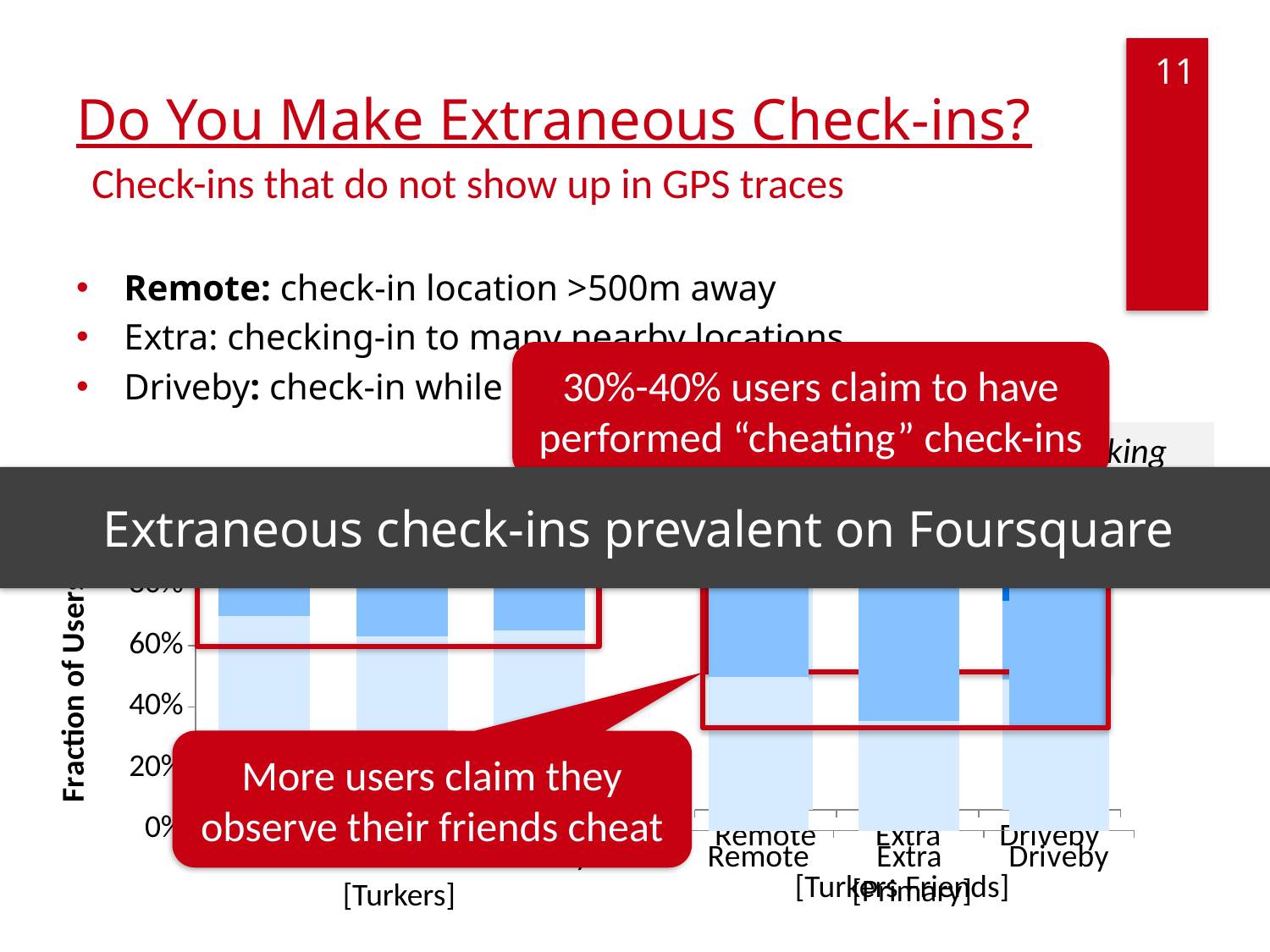
What kind of chart is shown on the slide? bar chart Is the total height of the Remote bar in the right-hand group greater or less than 60%? greater Is the total height of the Driveby bar in the right-hand group greater or less than 40%? greater How many categories are shown in the right-hand group of bars (Remote, Extra, Driveby)? 3 Is the total height of the Extra bar in the right-hand group greater or less than 60%? greater What is the label on the vertical axis of the chart? Fraction of Users What is the label of the left-hand group of bars on the x axis? [Turkers]